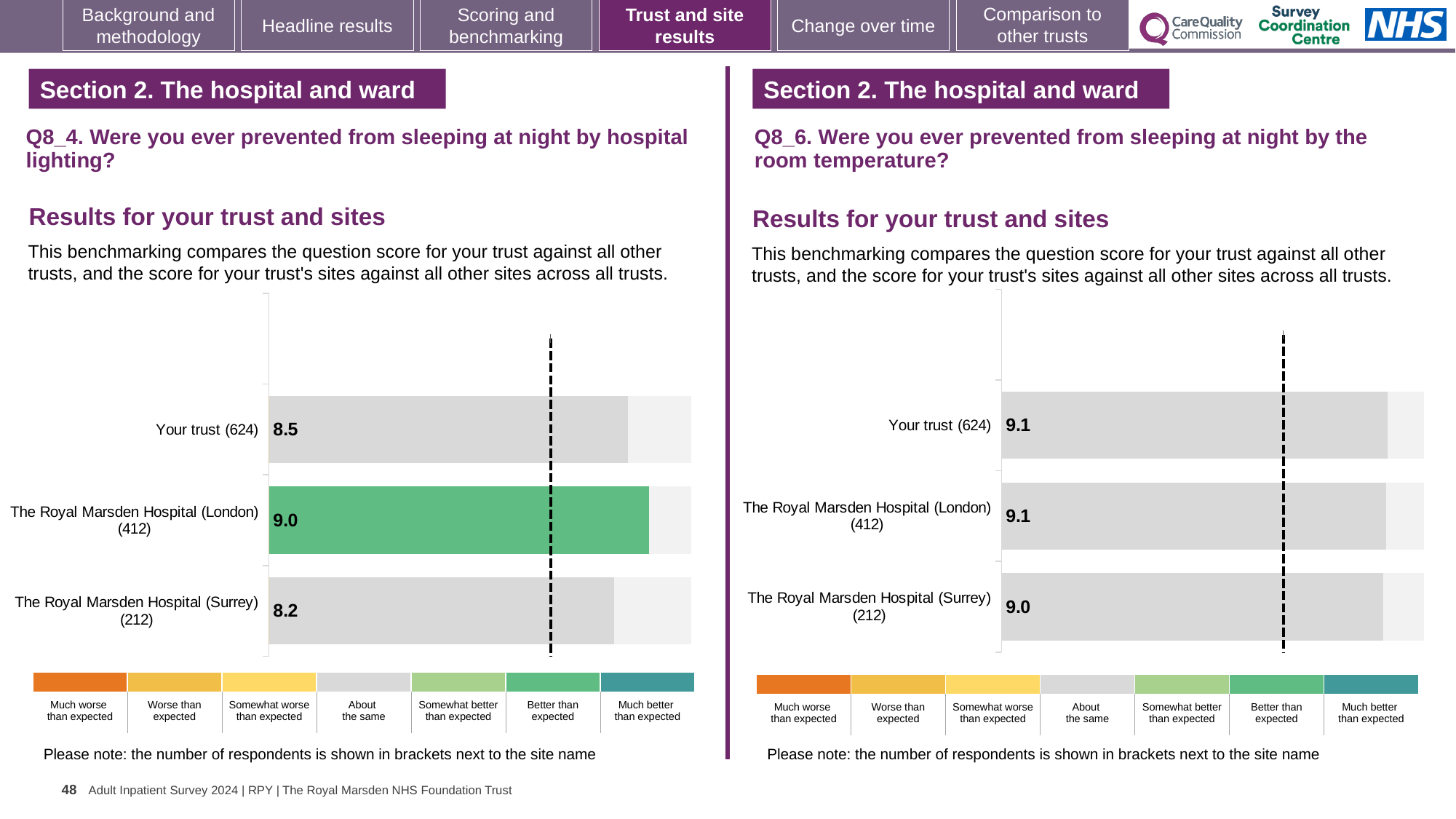
On the Q8_4 hospital lighting chart, which site or trust has the highest score? The Royal Marsden Hospital (London) (412) On the Q8_6 room temperature chart, what is the score for The Royal Marsden Hospital (Surrey) (212)? 9.0 What type of chart is used on the Q8_4 hospital lighting chart? Bar chart On the Q8_6 room temperature chart, what is the difference between the Your trust score and the Surrey site score? 0.1 On the Q8_4 hospital lighting chart, which site or trust has the lowest score? The Royal Marsden Hospital (Surrey) (212) How many bars are shown on the Q8_6 room temperature chart? 3 On the Q8_4 hospital lighting chart, what is the score for The Royal Marsden Hospital (London) (412)? 9.0 On the Q8_4 hospital lighting chart, what is the score for The Royal Marsden Hospital (Surrey) (212)? 8.2 On the Q8_6 room temperature chart, what is the score for Your trust (624)? 9.1 On the Q8_4 hospital lighting chart, what is the score for Your trust (624)? 8.5 On the Q8_4 hospital lighting chart, what is the difference between the London site score and the Surrey site score? 0.8 On the Q8_4 hospital lighting chart, which bar is coloured green? The Royal Marsden Hospital (London) (412)